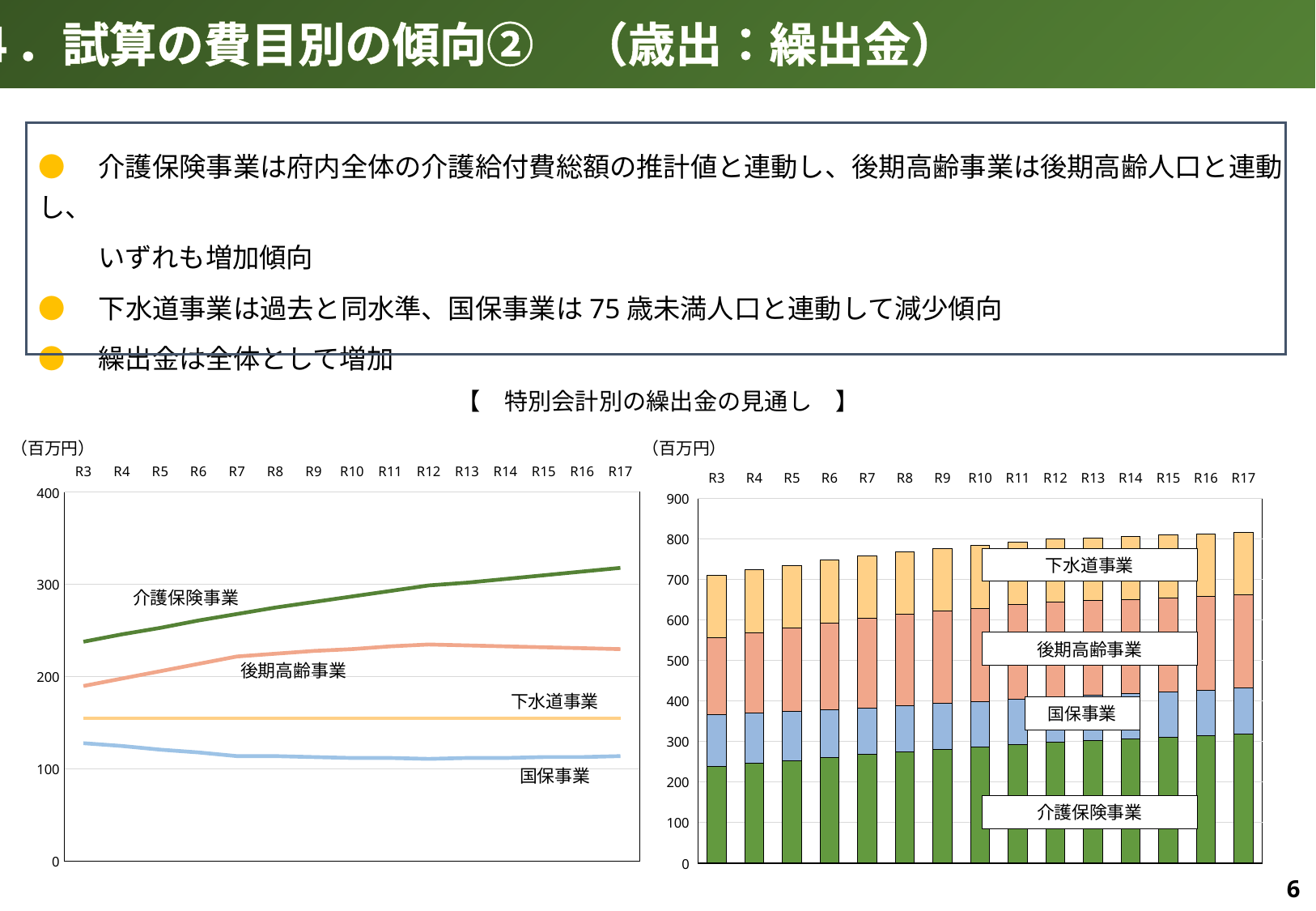
In the left chart, which series has the highest value at R17? 介護保険事業 In the left chart, is the value for 介護保険事業 at R17 greater or less than 300? greater In the left chart, does the 介護保険事業 line rise or fall from R3 to R17? rise In the right chart, is the total of the R3 bar greater or less than 800? less In the left chart, is the value for 下水道事業 at R3 greater or less than 200? less In the left chart, how many series are plotted? 4 What kind of chart is the right chart on the slide? bar chart In the left chart, does the 国保事業 line rise or fall from R3 to R17? fall In the left chart, which series has the lowest value at R17? 国保事業 In the left chart, how many years are shown on the x axis? 15 In the right chart, how many stacked bars are there? 15 What kind of chart is the left chart on the slide? line chart